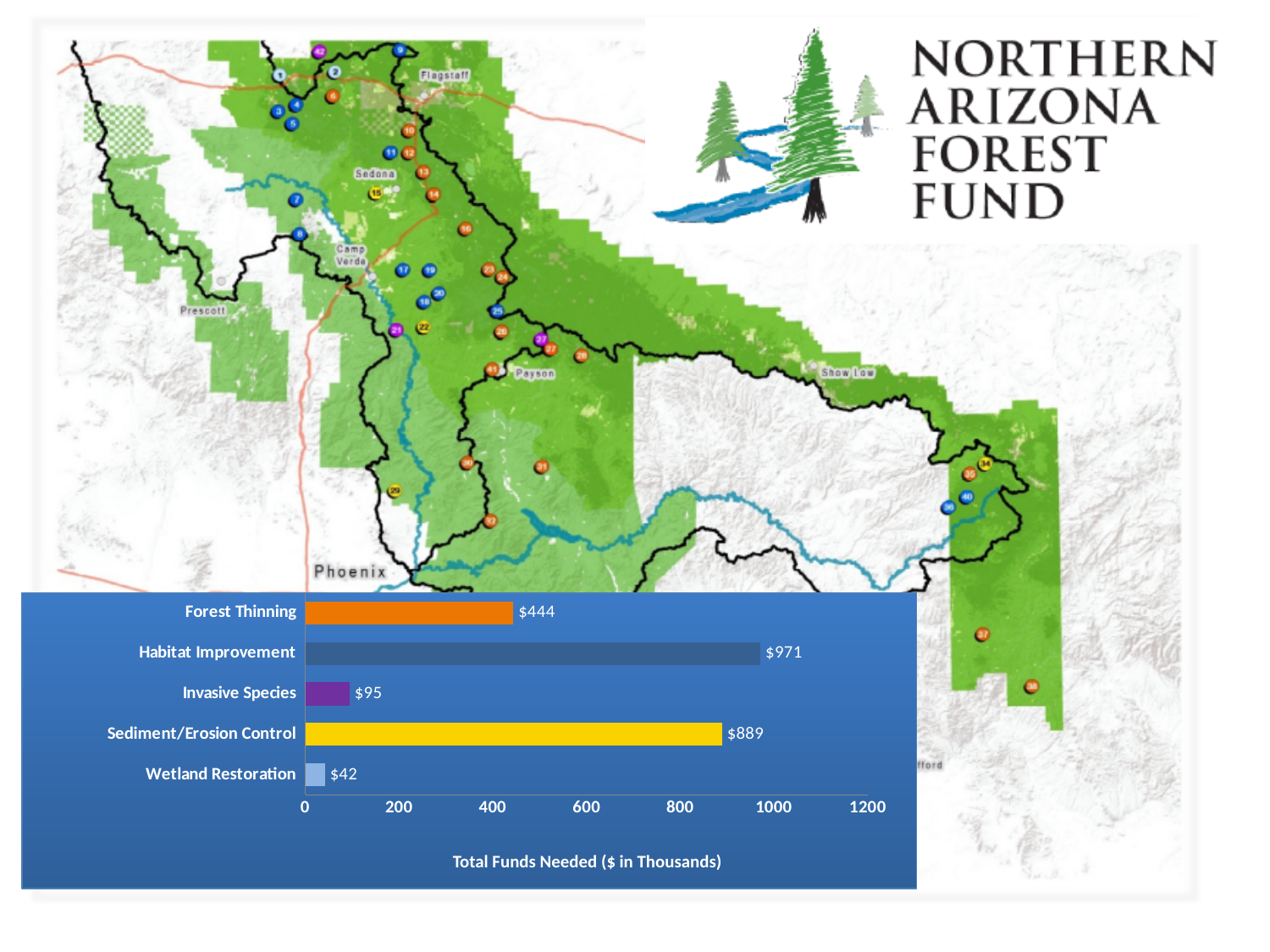
What is the difference between Habitat Improvement and Sediment/Erosion Control? $82 What is the value for Sediment/Erosion Control? $889 What is the value for Forest Thinning? $444 What is the value for Wetland Restoration? $42 Which is larger, Forest Thinning or Invasive Species? Forest Thinning Which category has the lowest value? Wetland Restoration How many categories are shown in the chart? 5 What kind of chart is shown? bar chart What is the axis title shown below the chart? Total Funds Needed ($ in Thousands) What is the value for Habitat Improvement? $971 Which category has the highest value? Habitat Improvement Is the value for Forest Thinning greater or less than 400? greater